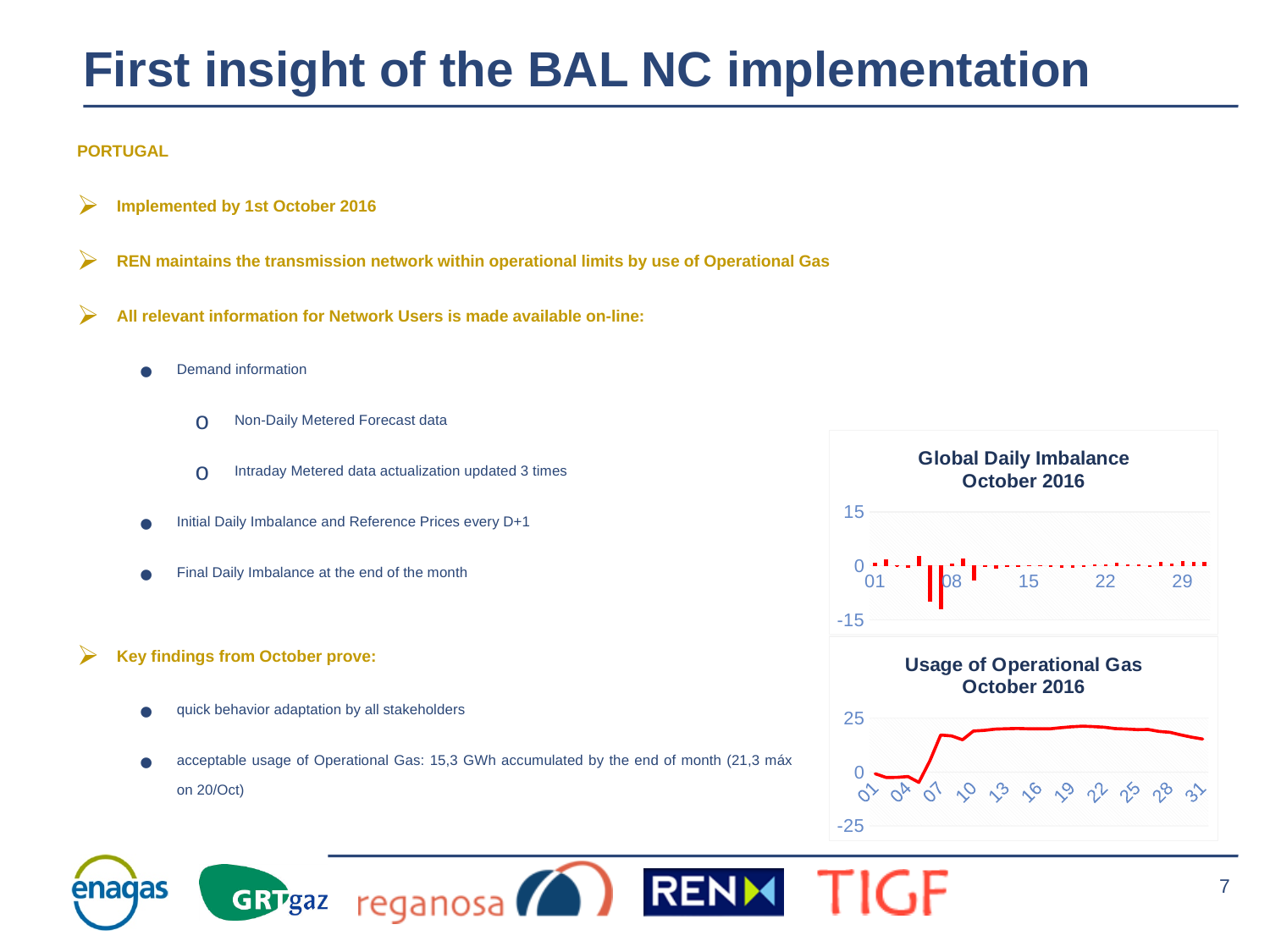
In the 'Usage of Operational Gas October 2016' chart, is the value for 16 greater or less than 0? greater In the 'Usage of Operational Gas October 2016' chart, is the value for 01 greater or less than 25? less What is the highest value shown on the y axis of the 'Usage of Operational Gas October 2016' chart? 25 What colour are the bars in the 'Global Daily Imbalance October 2016' chart? red In the 'Usage of Operational Gas October 2016' chart, does the line rise or fall between 04 and 10? rise In the 'Global Daily Imbalance October 2016' chart, is the value for 01 greater or less than 15? less What kind of chart is the 'Global Daily Imbalance October 2016' chart? bar chart What kind of chart is the 'Usage of Operational Gas October 2016' chart? line chart